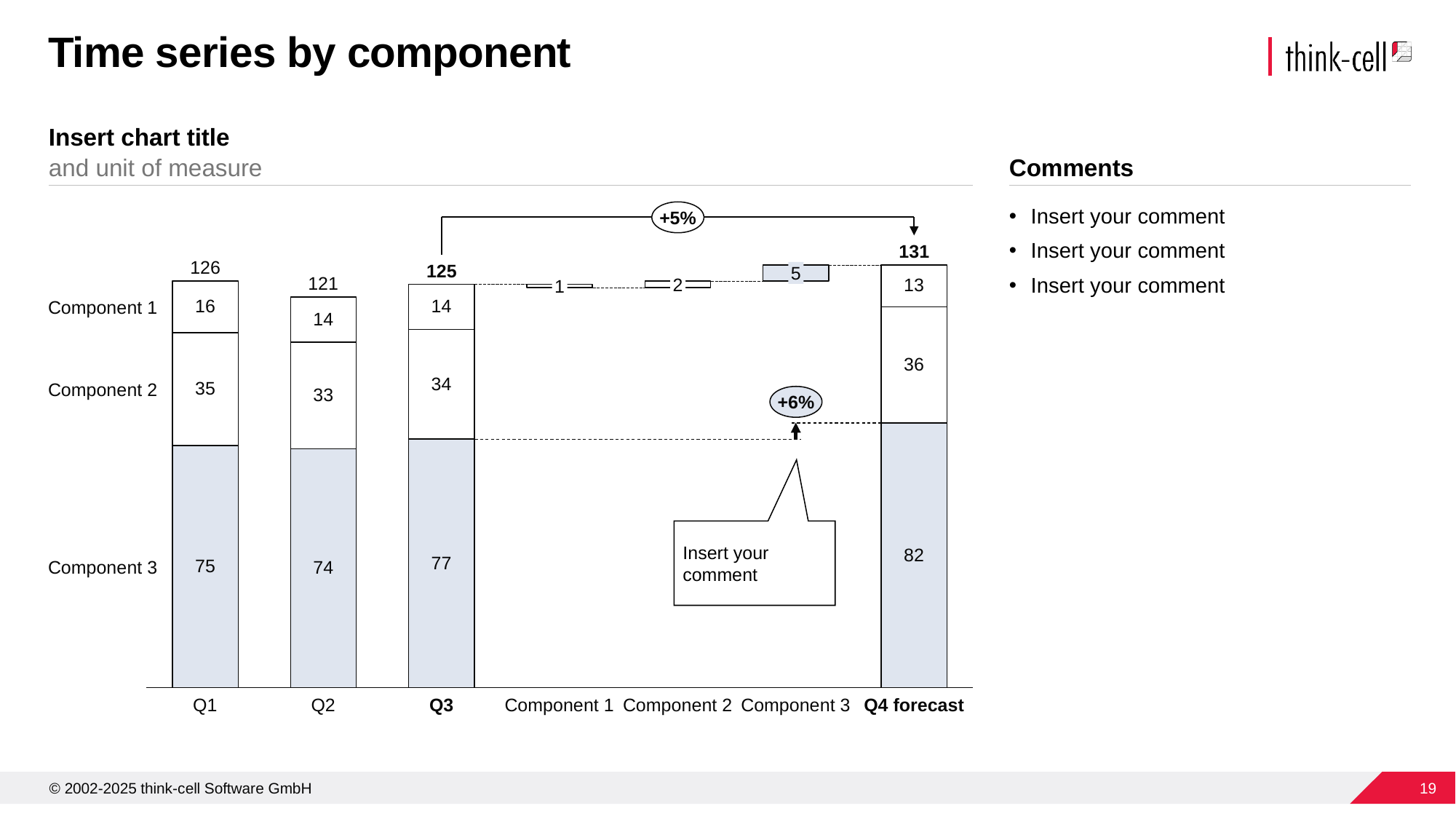
What is the Component 3 change shown in the bridge between Q3 and Q4 forecast? 5 Which period has the lowest total? Q2 What is the value of Component 3 in Q3? 77 What is the value of Component 1 in Q2? 14 What percentage change is shown between Q3 and Q4 forecast totals? +5% What is the value of Component 2 in Q4 forecast? 36 What is the total for Q1? 126 How many components are stacked in each bar? 3 Is Component 3 larger in Q1 or in Q2? Q1 Which period has the highest total? Q4 forecast What is the difference between the Q4 forecast total and the Q3 total? 6 What kind of chart is shown? Stacked bar chart